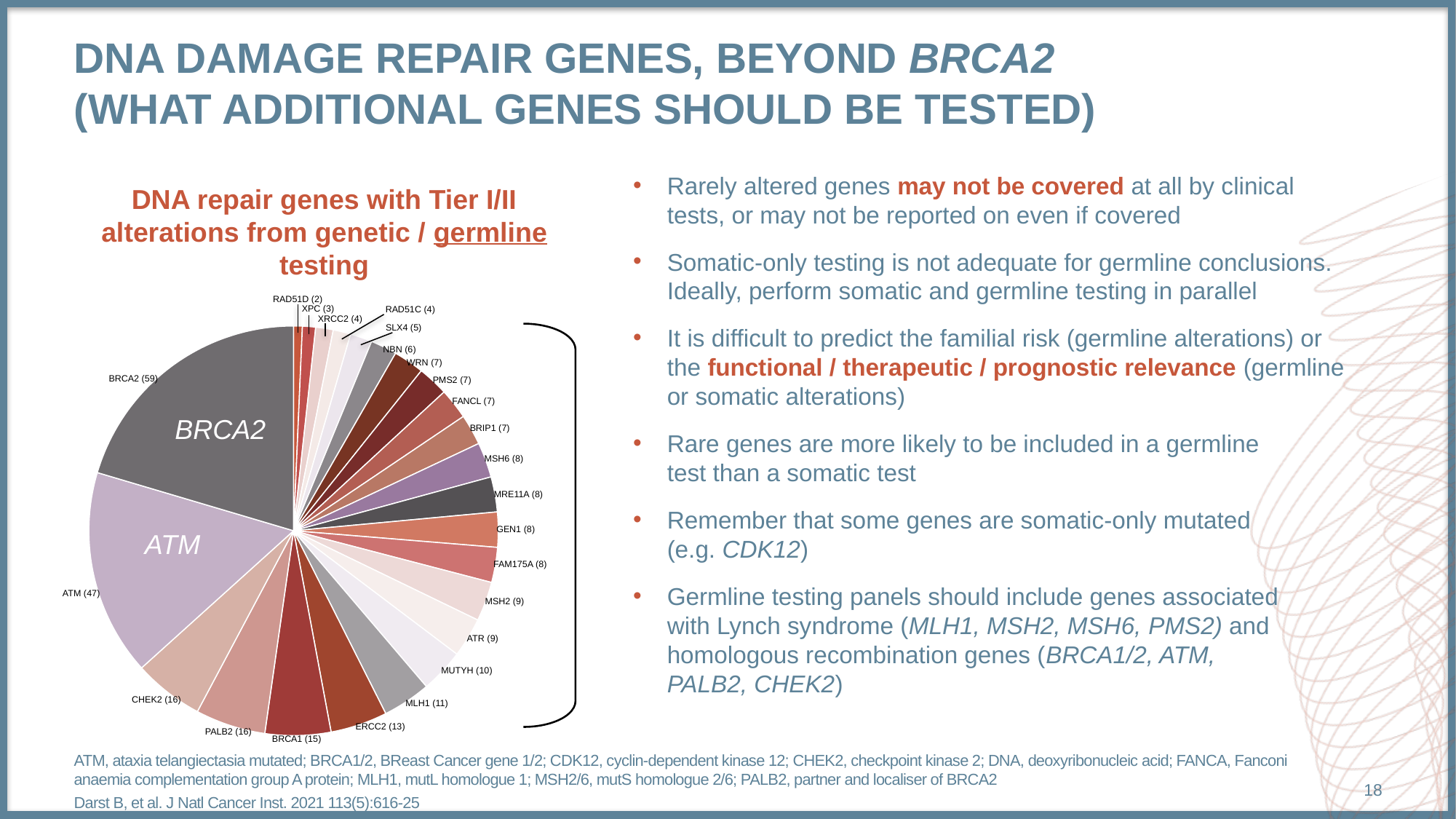
Which gene has the largest slice in the pie chart? BRCA2 What is the difference between the values for PALB2 and BRCA1? 1 What is the difference between the values for BRCA2 and ATM? 12 What is the value shown for BRCA2 in the pie chart? 59 What is the value shown for CHEK2 in the pie chart? 16 What type of chart is shown on the slide? Pie chart What is the title of the pie chart? DNA repair genes with Tier I/II alterations from genetic / germline testing Which has the larger value, ERCC2 or MUTYH? ERCC2 What is the value shown for MLH1 in the pie chart? 11 What is the value shown for ATM in the pie chart? 47 Which gene has the smallest slice in the pie chart? RAD51D How many genes (slices) are shown in the pie chart? 24